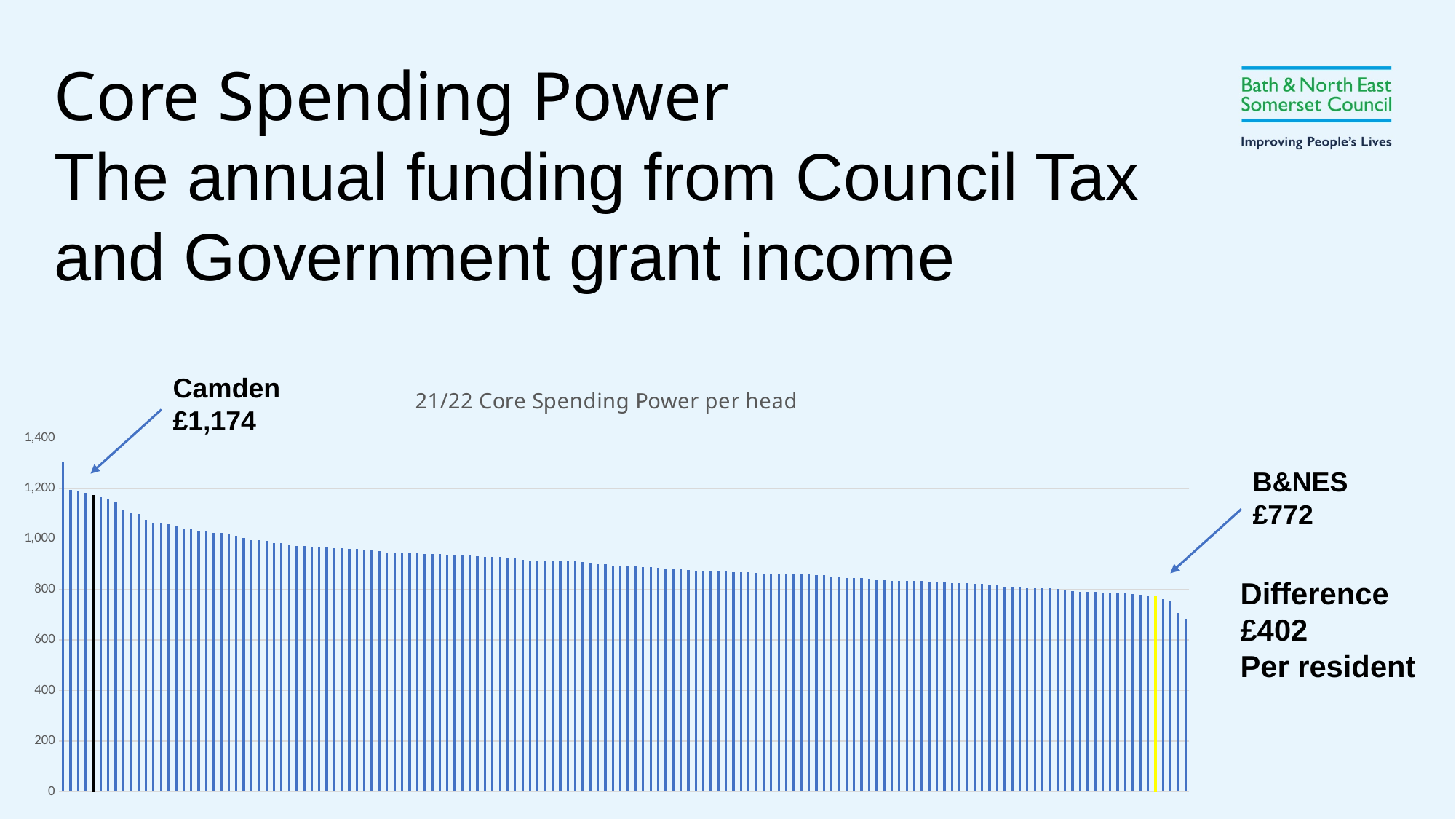
What colour is the bar highlighting B&NES? yellow Is the value for Camden greater or less than 1,000? greater Is the value for B&NES greater or less than 1,000? less What is the Core Spending Power per head for Camden? £1,174 What is the title of the chart? 21/22 Core Spending Power per head Which has the higher Core Spending Power per head, Camden or B&NES? Camden What is the highest value shown on the vertical axis? 1,400 Do the bar values rise or fall from left to right across the chart? fall What is the Core Spending Power per head for B&NES? £772 What is the difference per resident between Camden and B&NES? £402 What kind of chart is shown on the slide? bar chart